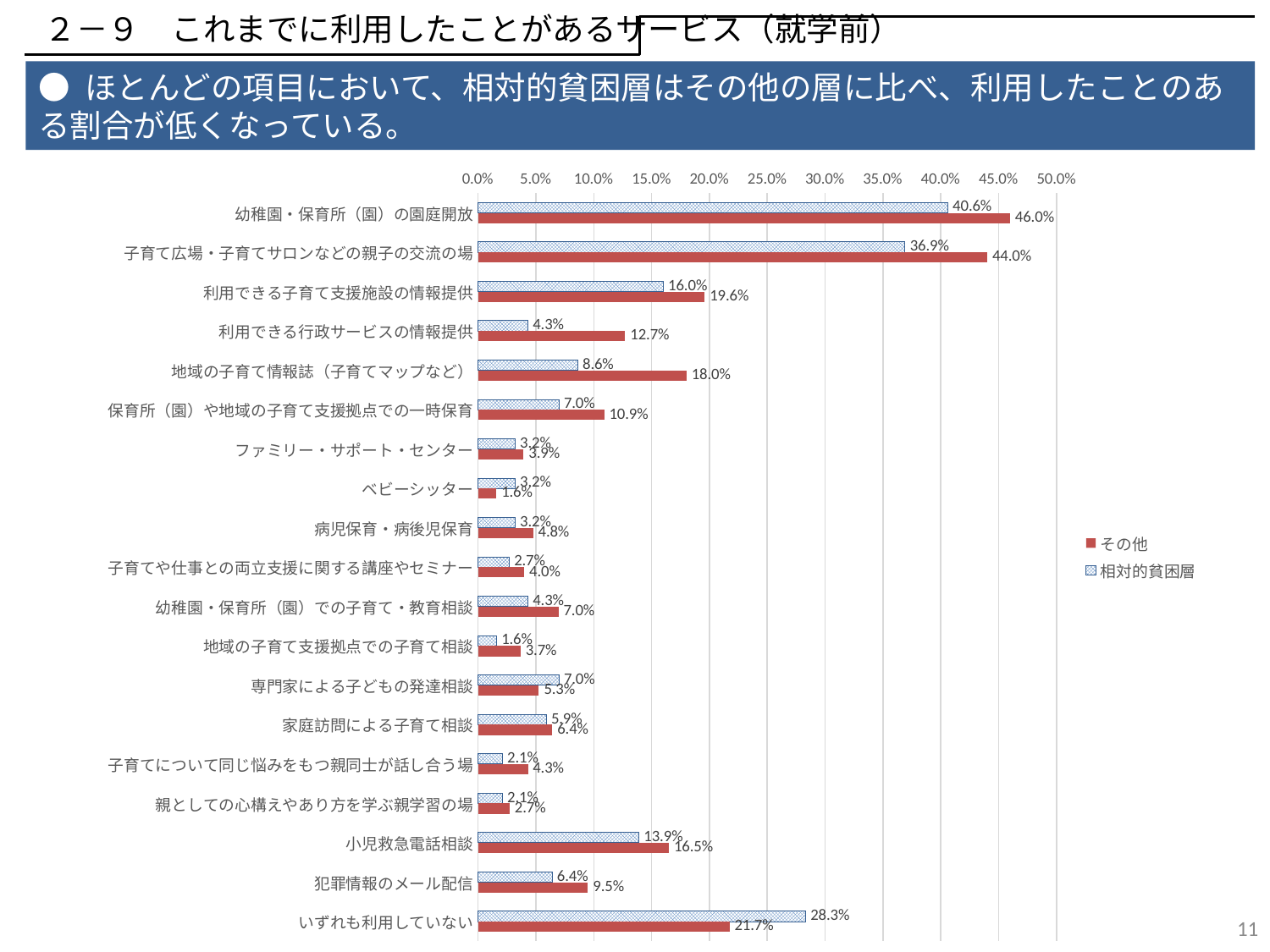
What is the value for 相対的貧困層 for 幼稚園・保育所（園）の園庭開放? 40.6% For 専門家による子どもの発達相談, which series has the larger value, その他 or 相対的貧困層? 相対的貧困層 Which category has the lowest value for その他? ベビーシッター How many categories are shown on the chart? 19 What kind of chart is shown on the slide? bar chart What is the value for 相対的貧困層 for いずれも利用していない? 28.3% What is the value for その他 for 地域の子育て情報誌（子育てマップなど）? 18.0% What is the value for その他 for 子育て広場・子育てサロンなどの親子の交流の場? 44.0% What is the difference between その他 and 相対的貧困層 for 利用できる行政サービスの情報提供? 8.4% Which series is shown in red in the legend? その他 Which category has the highest value for その他? 幼稚園・保育所（園）の園庭開放 How many series does the legend list? 2